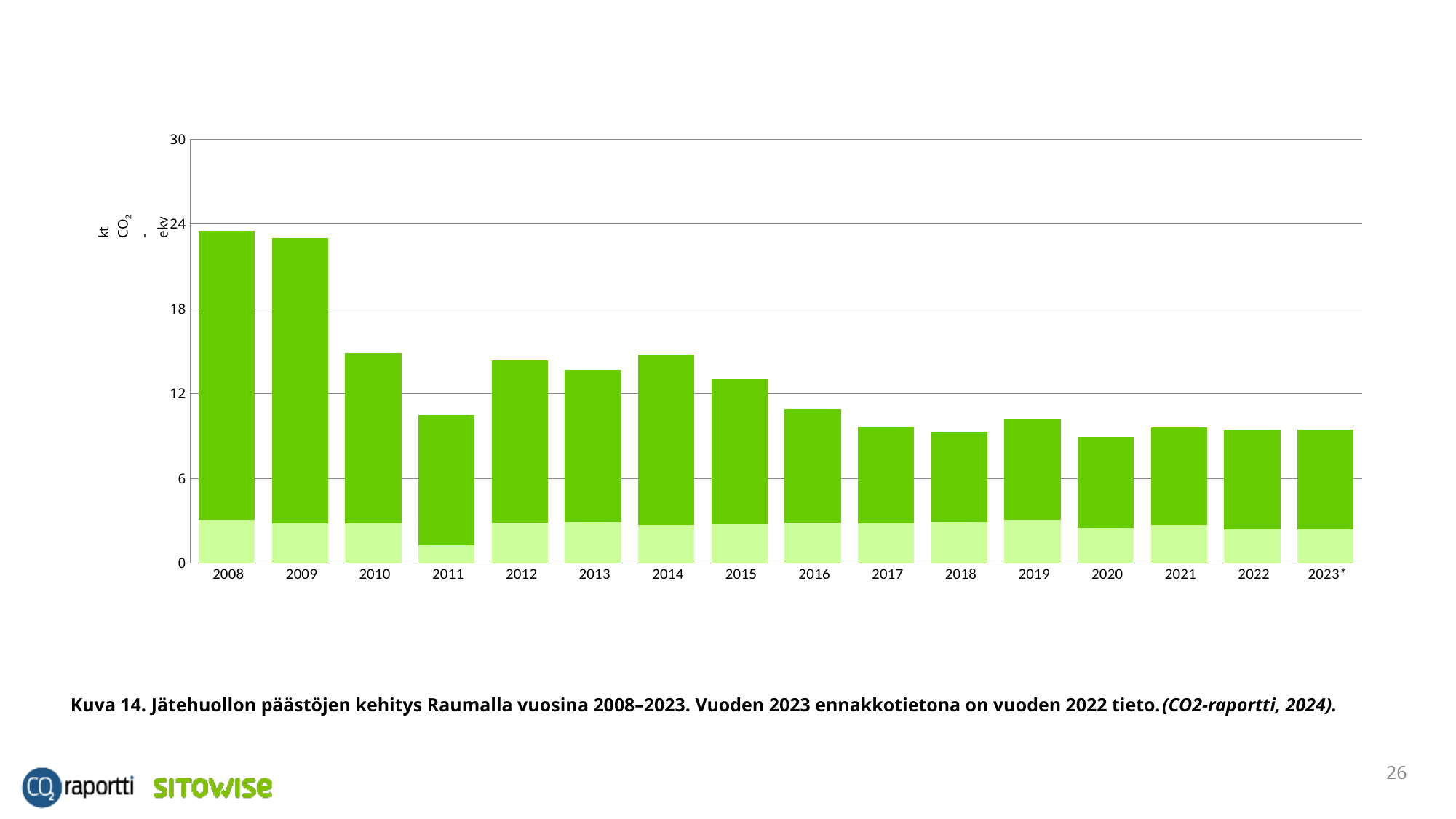
Which year has the larger total bar, 2014 or 2015? 2014 What kind of chart is shown on the slide? Stacked bar chart Which year has the larger total bar, 2010 or 2011? 2010 Is the total value for 2011 greater or less than 12? less Is the total value for 2010 greater or less than 12? greater Which year has the highest total bar in the chart? 2008 Do the total values generally rise or fall from 2008 to 2023? fall How many years (bars) are shown on the x axis of the chart? 16 Is the total value for 2008 greater or less than 18? greater What unit is shown on the y axis of the chart? kt CO2-ekv